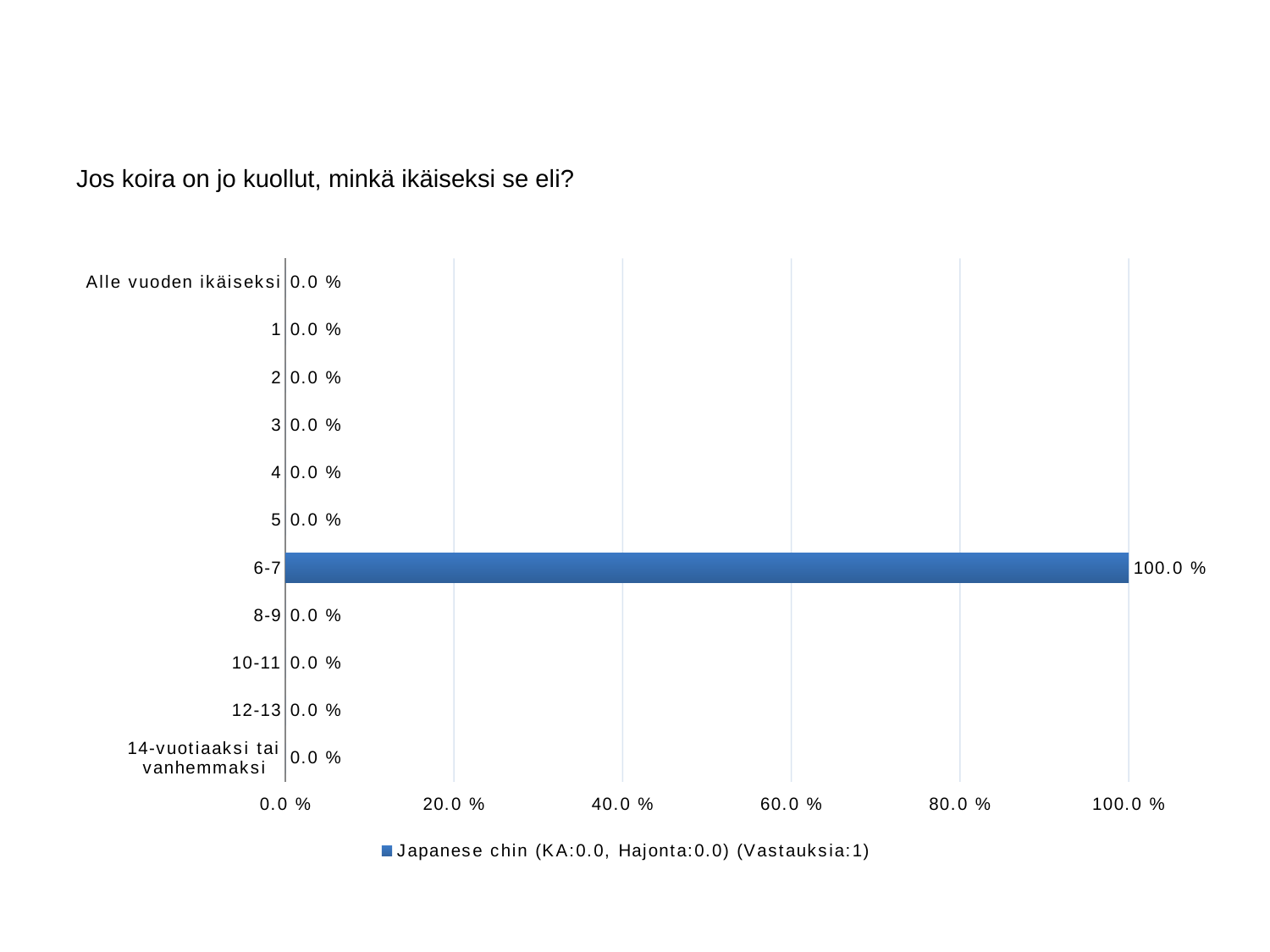
What is the title of the chart? Jos koira on jo kuollut, minkä ikäiseksi se eli? Which category has the highest value? 6-7 Which is larger, the value for 6-7 or the value for 10-11? 6-7 Is the value for 6-7 greater or less than 80.0 %? greater What is the legend entry for the series? Japanese chin (KA:0.0, Hajonta:0.0) (Vastauksia:1) What is the value for the 6-7 category? 100.0 % How many categories are shown on the chart? 11 What is the value for the 'Alle vuoden ikäiseksi' category? 0.0 % What is the value for the 8-9 category? 0.0 % What is the difference between the values for 6-7 and 12-13? 100.0 % How many series does the legend list? 1 What kind of chart is shown on the slide? bar chart